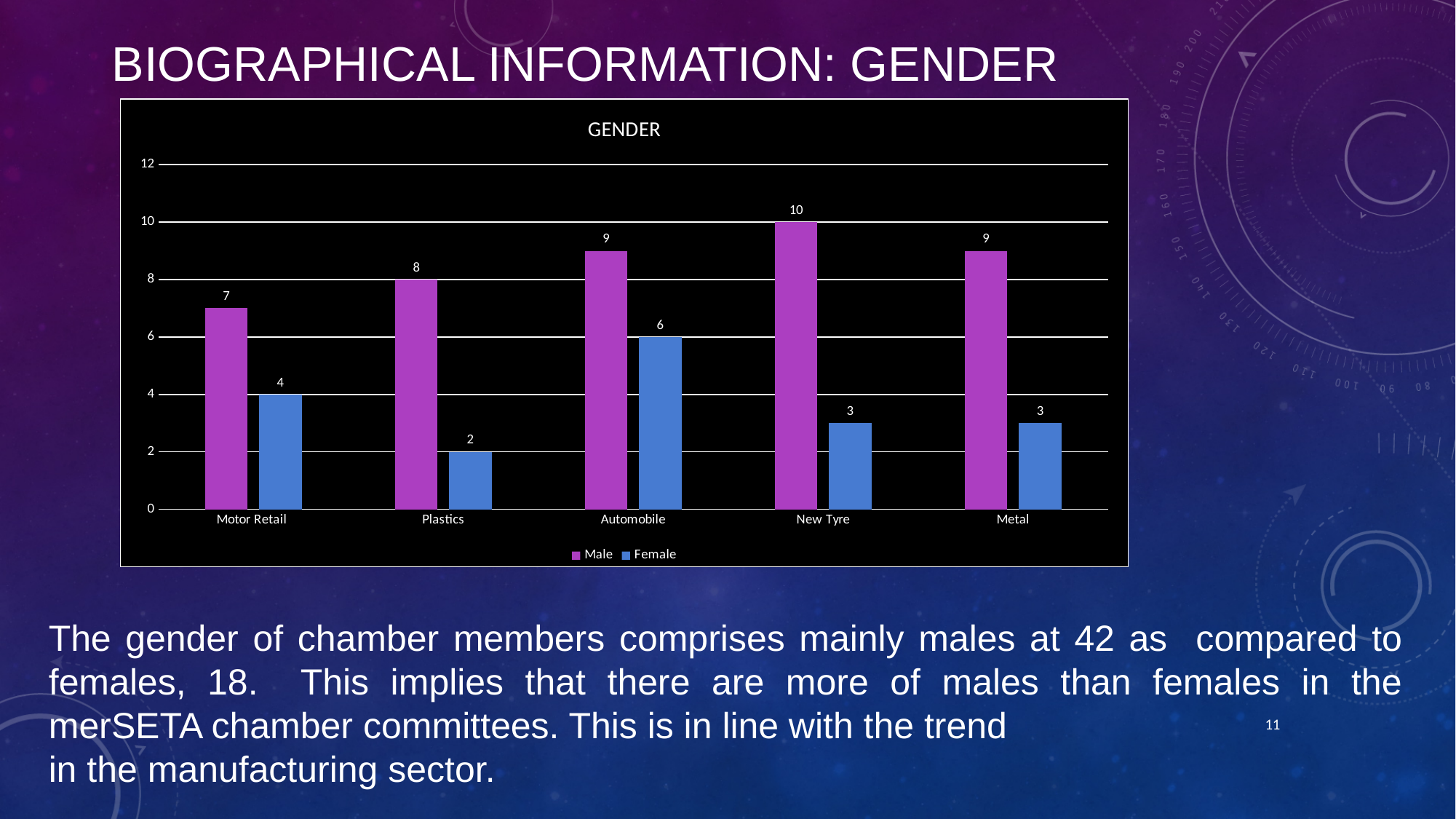
What is the Male value for New Tyre? 10 Is the Male value for Plastics greater or less than 6? greater Which is larger: the Female value for Automobile or the Female value for Metal? Automobile How many series does the legend list? 2 Which category has the lowest Female value? Plastics Which category has the highest Male value? New Tyre What is the title of the chart? GENDER What is the difference between the Male and Female values for Motor Retail? 3 How many categories are shown on the x axis? 5 What is the Female value for Automobile? 6 What is the Female value for Plastics? 2 What kind of chart is shown? bar chart